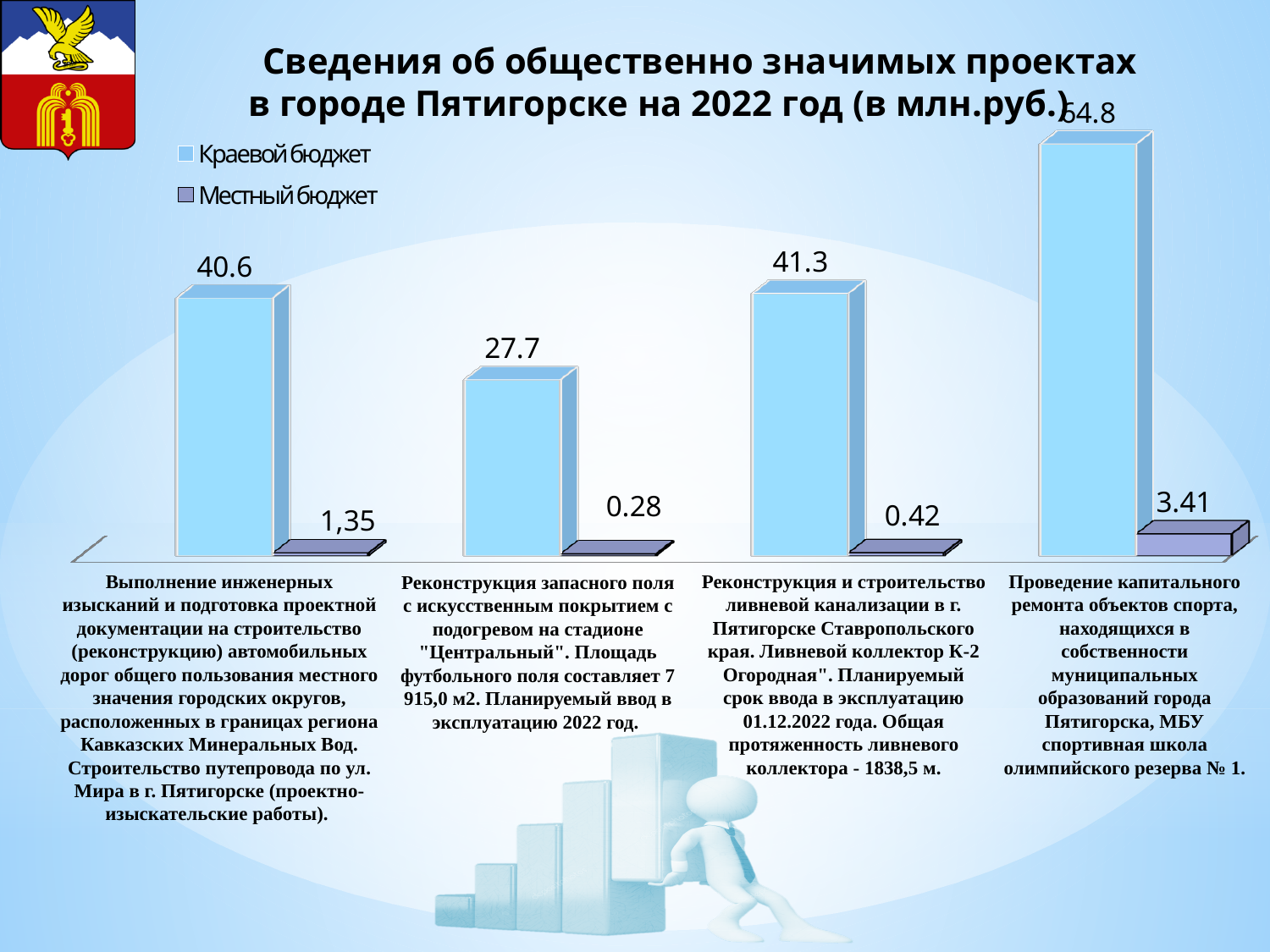
What is the Краевой бюджет value for the project 'Реконструкция и строительство ливневой канализации в г. Пятигорске'? 41.3 What kind of chart is shown on the slide? bar chart What is the difference between the Краевой бюджет values for 'Проведение капитального ремонта объектов спорта' (64.8) and 'Реконструкция и строительство ливневой канализации' (41.3)? 23.5 How many project categories are shown on the x axis? 4 Which project has the lowest Краевой бюджет value? Реконструкция запасного поля с искусственным покрытием с подогревом на стадионе "Центральный" Which project has the highest Краевой бюджет value? Проведение капитального ремонта объектов спорта What is the Местный бюджет value for the project 'Проведение капитального ремонта объектов спорта'? 3.41 What is the Местный бюджет value for the project 'Выполнение инженерных изысканий и подготовка проектной документации'? 1,35 What is the Краевой бюджет value for the project 'Реконструкция запасного поля с искусственным покрытием с подогревом на стадионе "Центральный"'? 27.7 Which legend entry is shown in light blue? Краевой бюджет Which project has the highest Местный бюджет value? Проведение капитального ремонта объектов спорта How many series does the legend list? 2